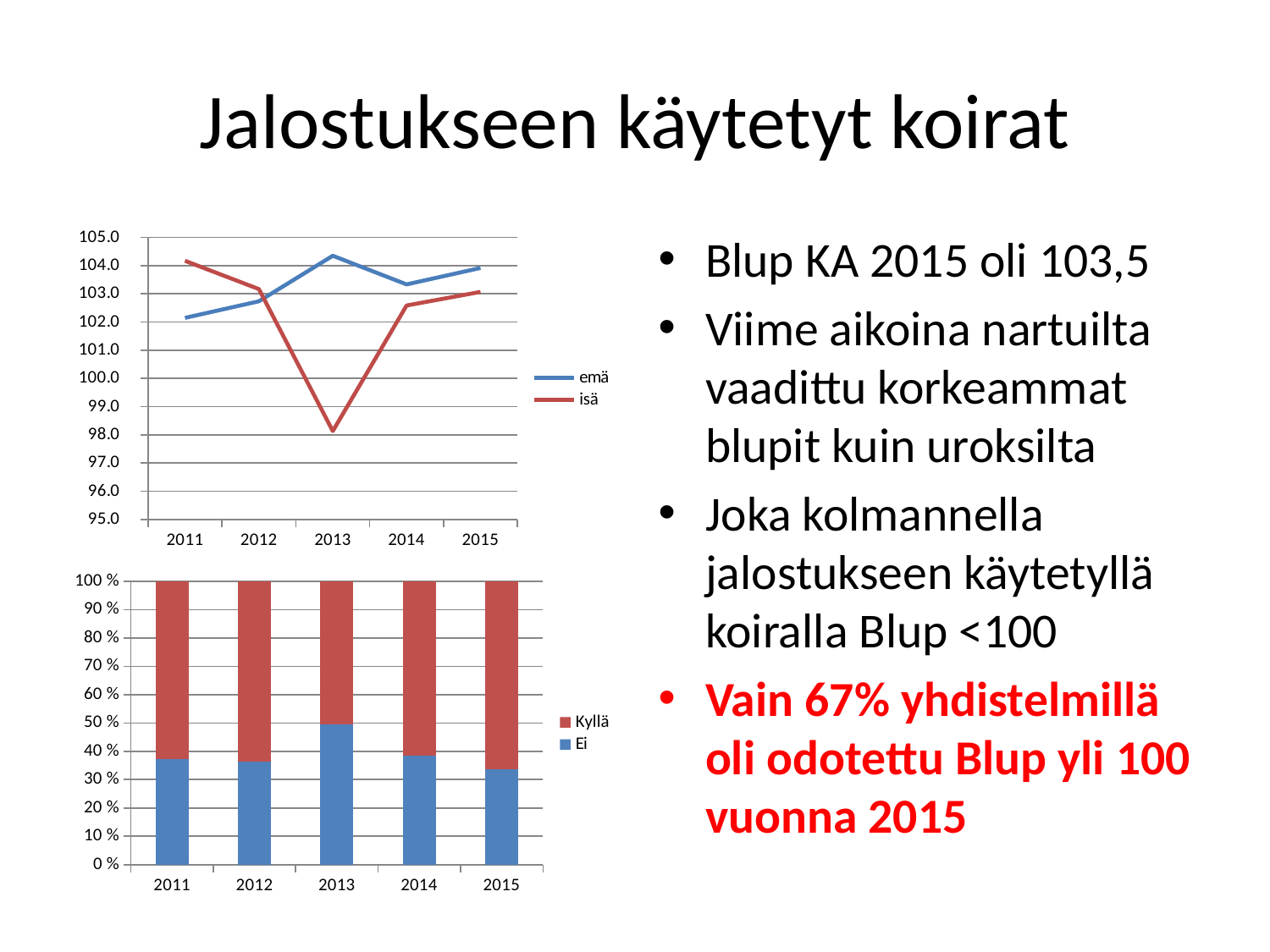
In the bottom chart, what are the two legend entries? Kyllä and Ei In the top chart, which series has the higher value in 2011, emä or isä? isä In the top chart, in which year is the value for isä lowest? 2013 In the top chart, in which year is the value for isä highest? 2011 In the bottom chart, is the Ei share in 2015 greater or less than 40 %? less In the top chart, how many series does the legend list? 2 In the bottom chart, in which year is the Ei share largest? 2013 In the top chart, how many years are shown on the x axis? 5 In the top chart, is the value for isä in 2013 greater or less than 100.0? less What kind of chart is the top chart on the slide? line chart In the top chart, is the value for emä in 2013 greater or less than 103.0? greater What kind of chart is the bottom chart on the slide? bar chart